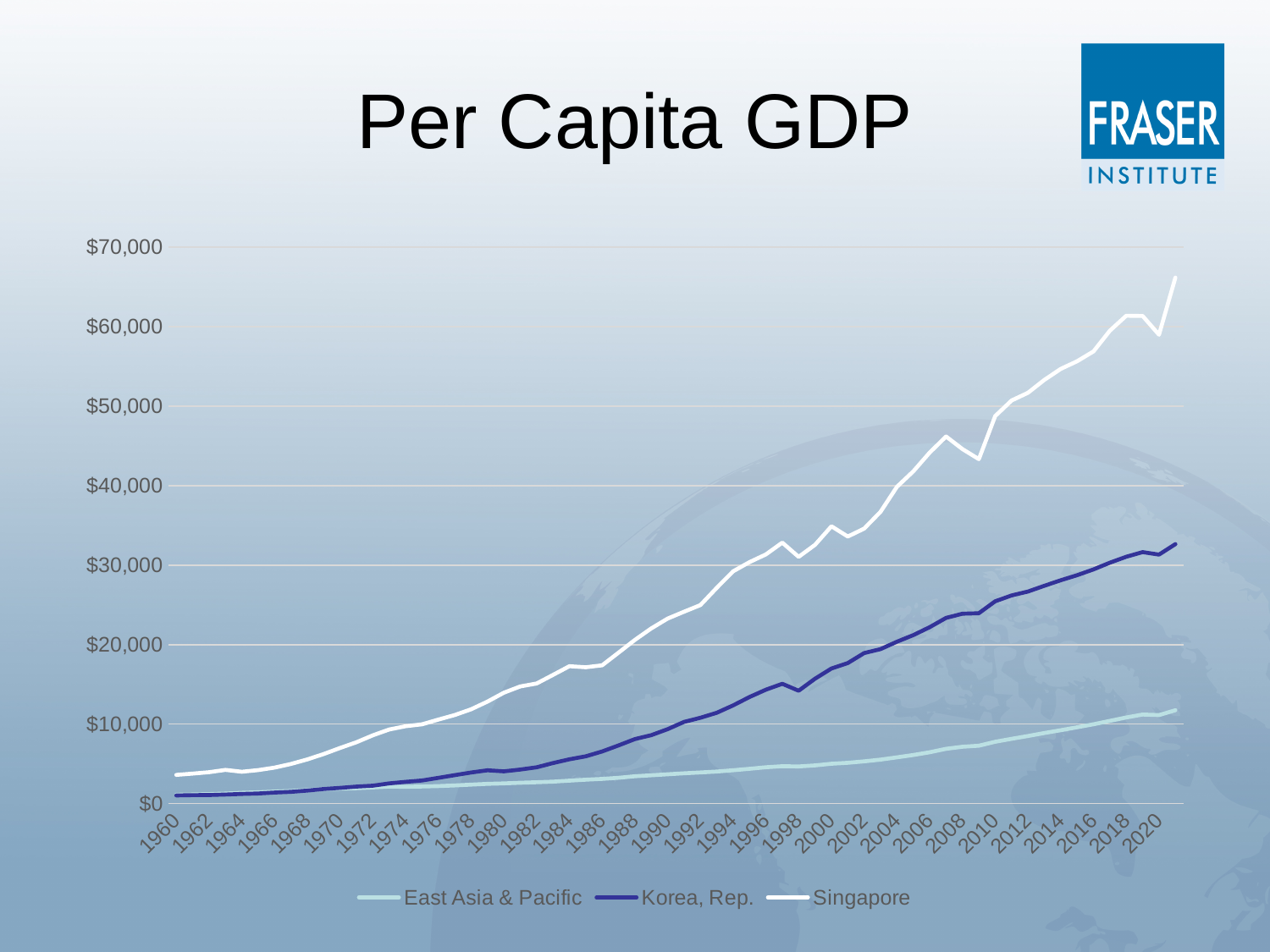
What kind of chart is shown on the slide? line chart Is the value for Singapore in 1960 greater or less than $10,000? less How many series does the legend list? 3 What is the title of the chart? Per Capita GDP Is the value for Singapore in 2020 greater or less than $50,000? greater Is the value for East Asia & Pacific in 2020 greater or less than $20,000? less Which series has the highest value in 2020? Singapore In 2000, which is larger: the value for Singapore or the value for Korea, Rep.? Singapore Which series has the lowest value in 2020? East Asia & Pacific Which series is drawn with the dark blue line? Korea, Rep. Does the Korea, Rep. line rise or fall from 1960 to 2020? rise